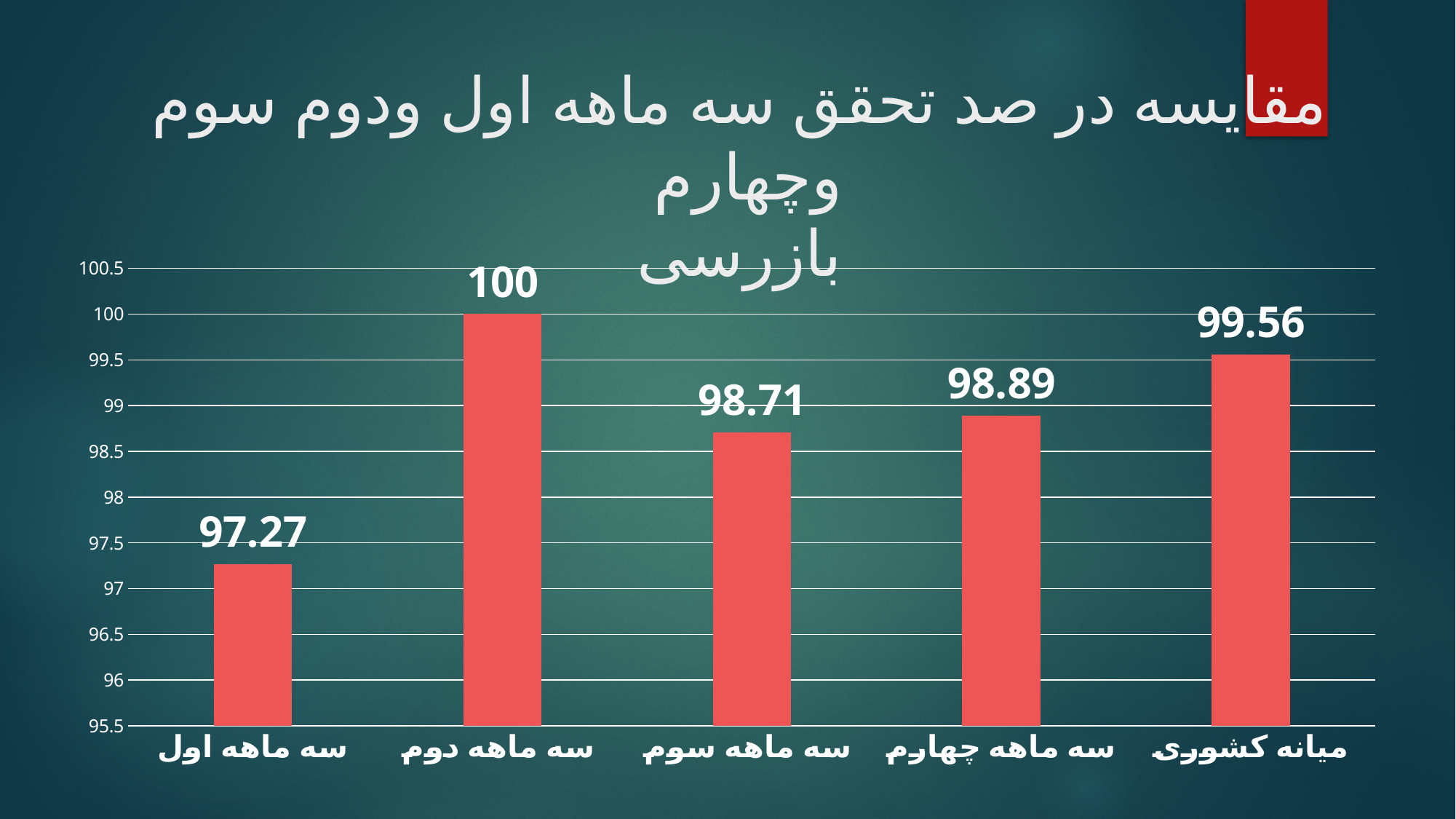
Which category has the highest value? سه ماهه دوم What is the value for میانه کشوری (national median)? 99.56 What is the difference between the values for سه ماهه چهارم and سه ماهه سوم? 0.18 How many bars are shown in the chart? 5 What kind of chart is shown on the slide? bar chart What is the value for سه ماهه سوم (third quarter)? 98.71 Which is larger, the value for سه ماهه چهارم or the value for میانه کشوری? میانه کشوری What is the difference between the values for سه ماهه دوم and سه ماهه اول? 2.73 Is the value for سه ماهه سوم greater or less than 99? less Which category has the lowest value? سه ماهه اول What is the value for سه ماهه اول (first quarter)? 97.27 What is the value for سه ماهه دوم (second quarter)? 100